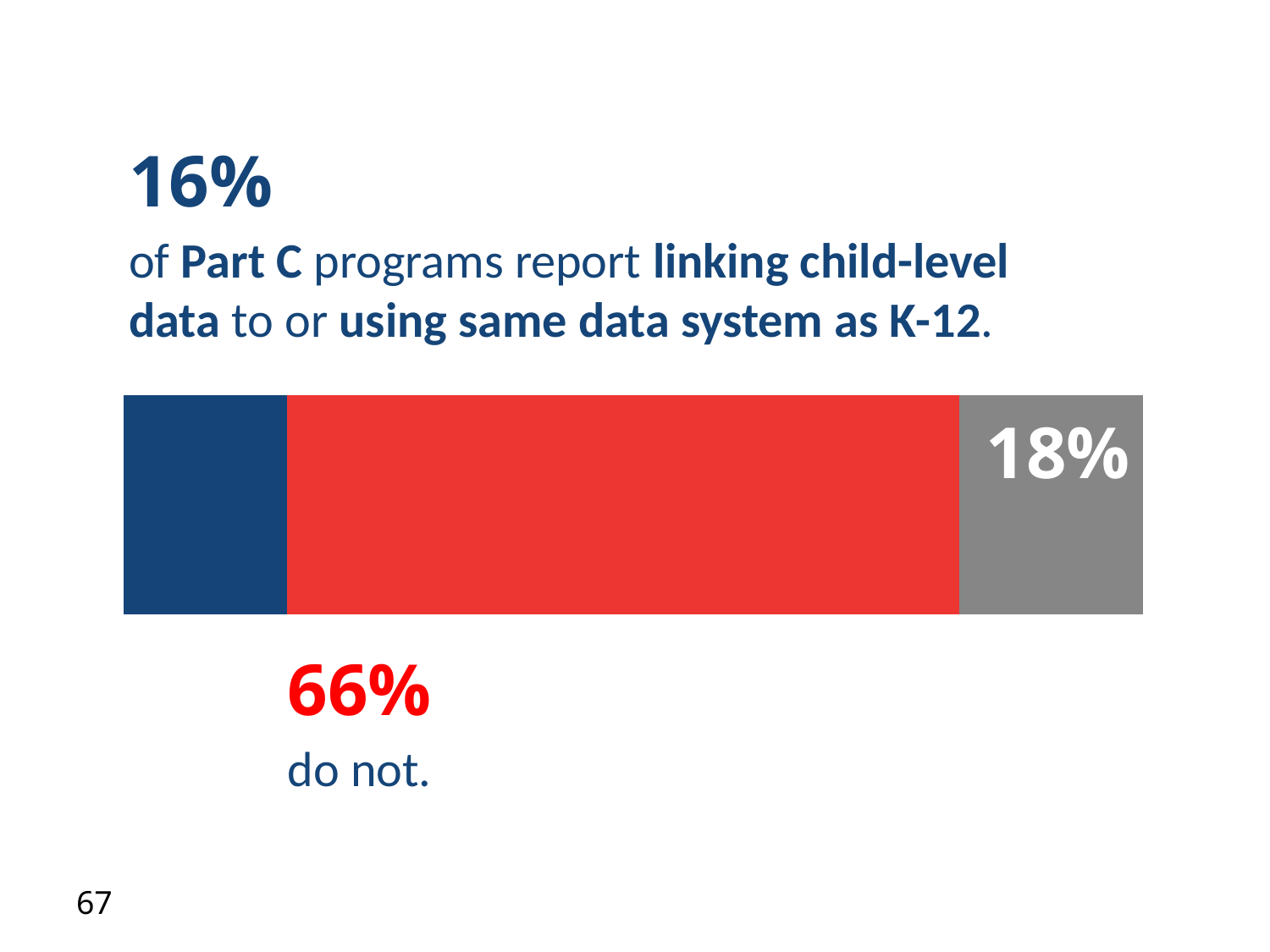
What is the difference between the share that do not link data (66%) and the share that do (16%)? 50 percentage points What percentage of Part C programs report linking child-level data to or using the same data system as K-12? 16% What percentage of Part C programs do not link child-level data to or use the same data system as K-12? 66% What colour is the segment representing the 66% that do not link data? Red What value is printed on the gray segment of the bar? 18% What is the total of the three segments in the stacked bar? 100% Which is larger, the gray segment or the blue segment? The gray segment Which is larger, the red segment or the gray segment? The red segment Which segment of the bar is the smallest? The blue segment (16%) Which segment of the bar is the largest? The red segment (66%) How many segments make up the stacked bar? 3 What kind of chart is shown on the slide? A stacked bar chart